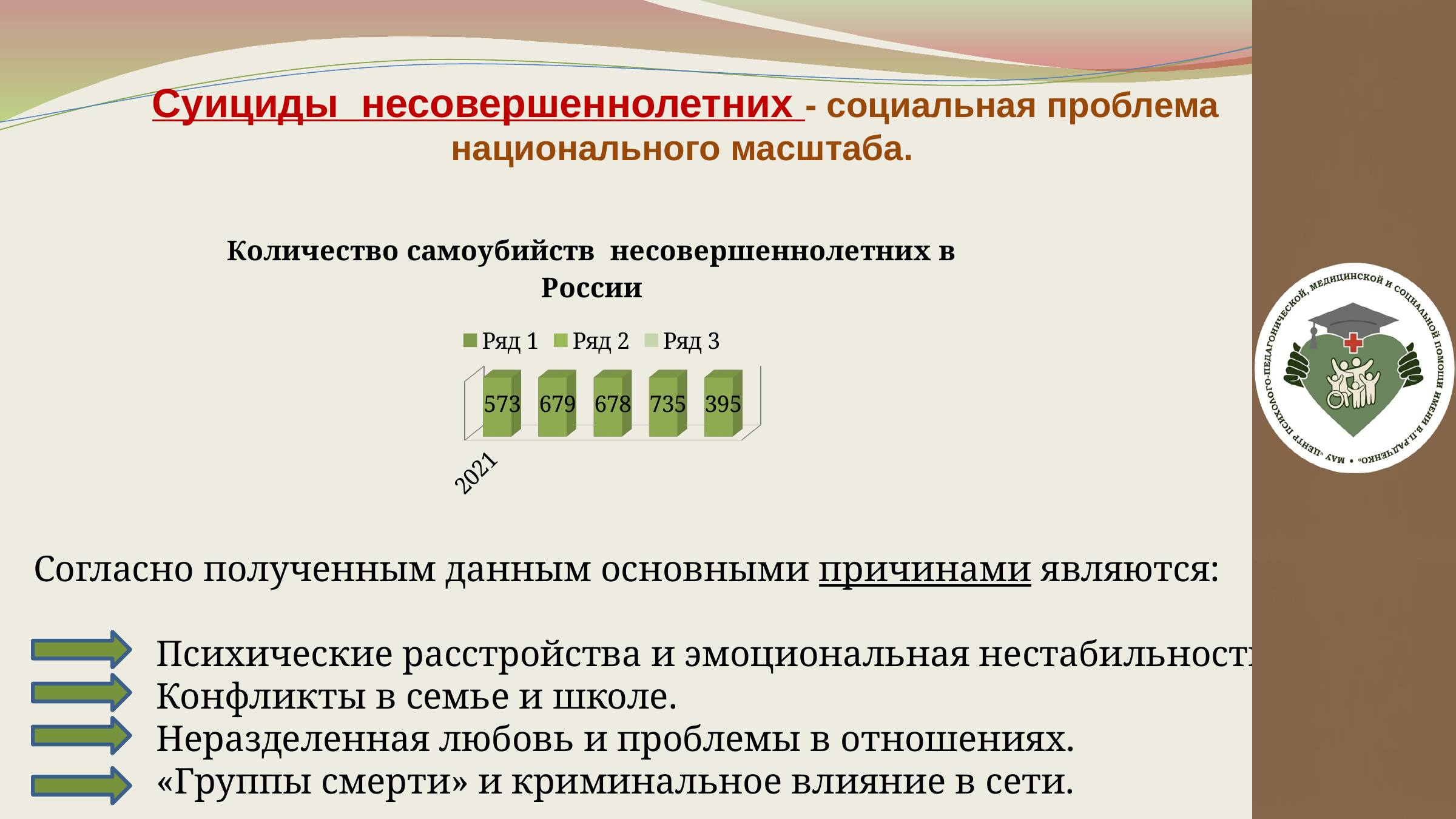
How many series does the chart legend list? 3 What value is labelled on the leftmost bar of the chart? 573 What value is labelled on the fourth bar from the left in the chart? 735 What is the title of the chart on the slide? Количество самоубийств несовершеннолетних в России What is the lowest value labelled on the bars in the chart? 395 What is the difference between the highest and lowest bar values in the chart? 340 How many bars are plotted in the chart? 5 What is the difference between the second bar (679) and the third bar (678) in the chart? 1 Which is larger, the leftmost bar or the rightmost bar in the chart? the leftmost bar (573) What value is labelled on the rightmost bar of the chart? 395 What is the highest value labelled on the bars in the chart? 735 What kind of chart is shown on the slide? bar chart